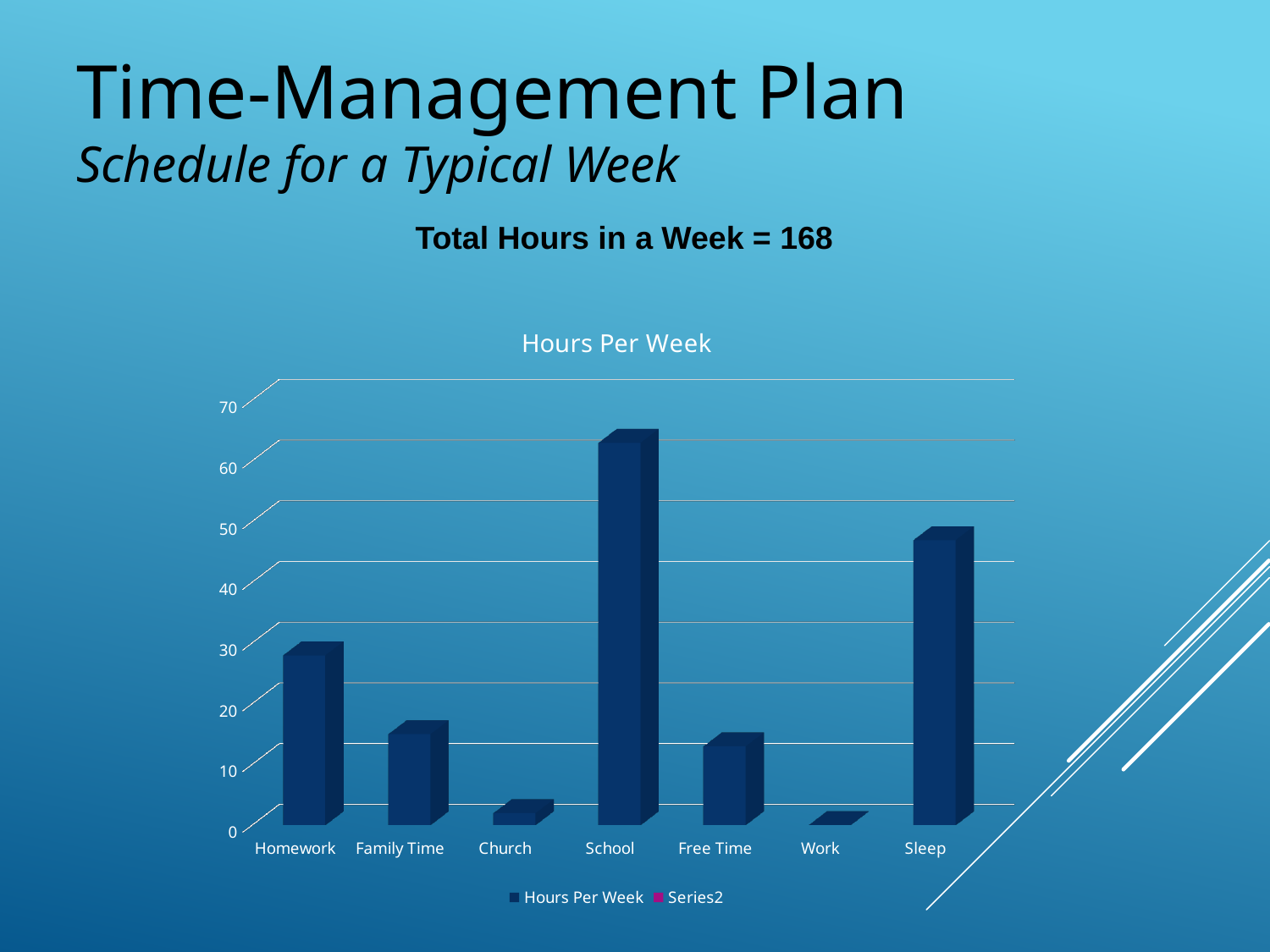
What kind of chart is shown on the slide? bar chart Is the value for Sleep greater or less than 40? greater Which category has the lowest value in the chart? Work Which is larger, the value for Homework or the value for Family Time? Homework Is the value for Homework greater or less than 20? greater Is the value for School greater or less than 50? greater Which is larger, the value for Sleep or the value for Homework? Sleep How many series does the chart legend list? 2 Which category has the highest value in the chart? School What is the title of the chart? Hours Per Week How many categories are shown on the x axis of the chart? 7